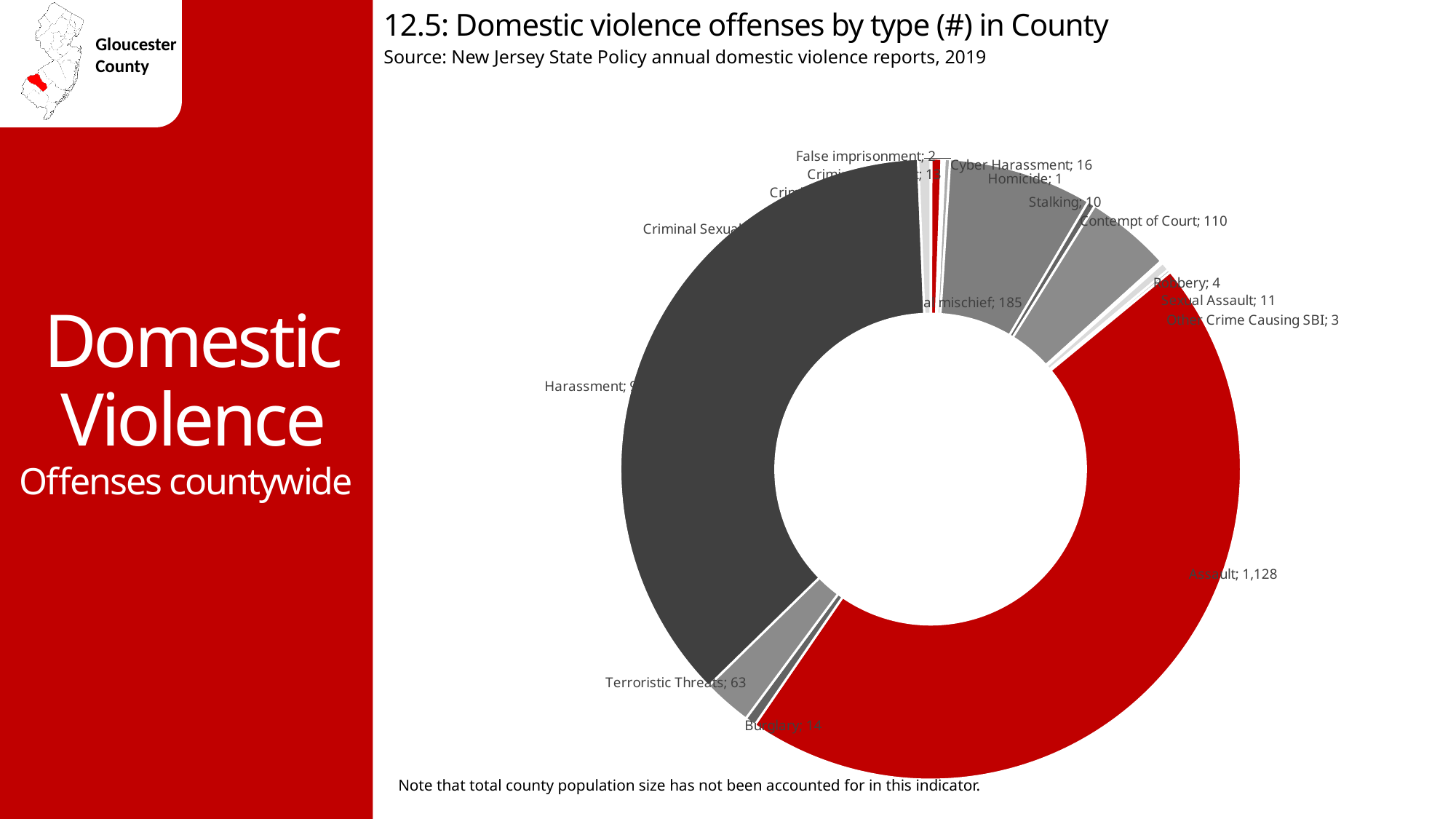
What is the title of the chart? 12.5: Domestic violence offenses by type (#) in County What is the value for Contempt of Court? 110 What is the value for Terroristic Threats? 63 Which is larger, the value for Cyber Harassment or the value for Stalking? Cyber Harassment What is the difference between the values for Contempt of Court and Terroristic Threats? 47 What is the value for Stalking? 10 What kind of chart is shown on the slide? pie chart (donut) What is the value for Sexual Assault? 11 Which offense type has the highest number of offenses? Assault What is the value for Homicide? 1 What is the value for Cyber Harassment? 16 How many domestic violence offenses are recorded for Assault? 1,128